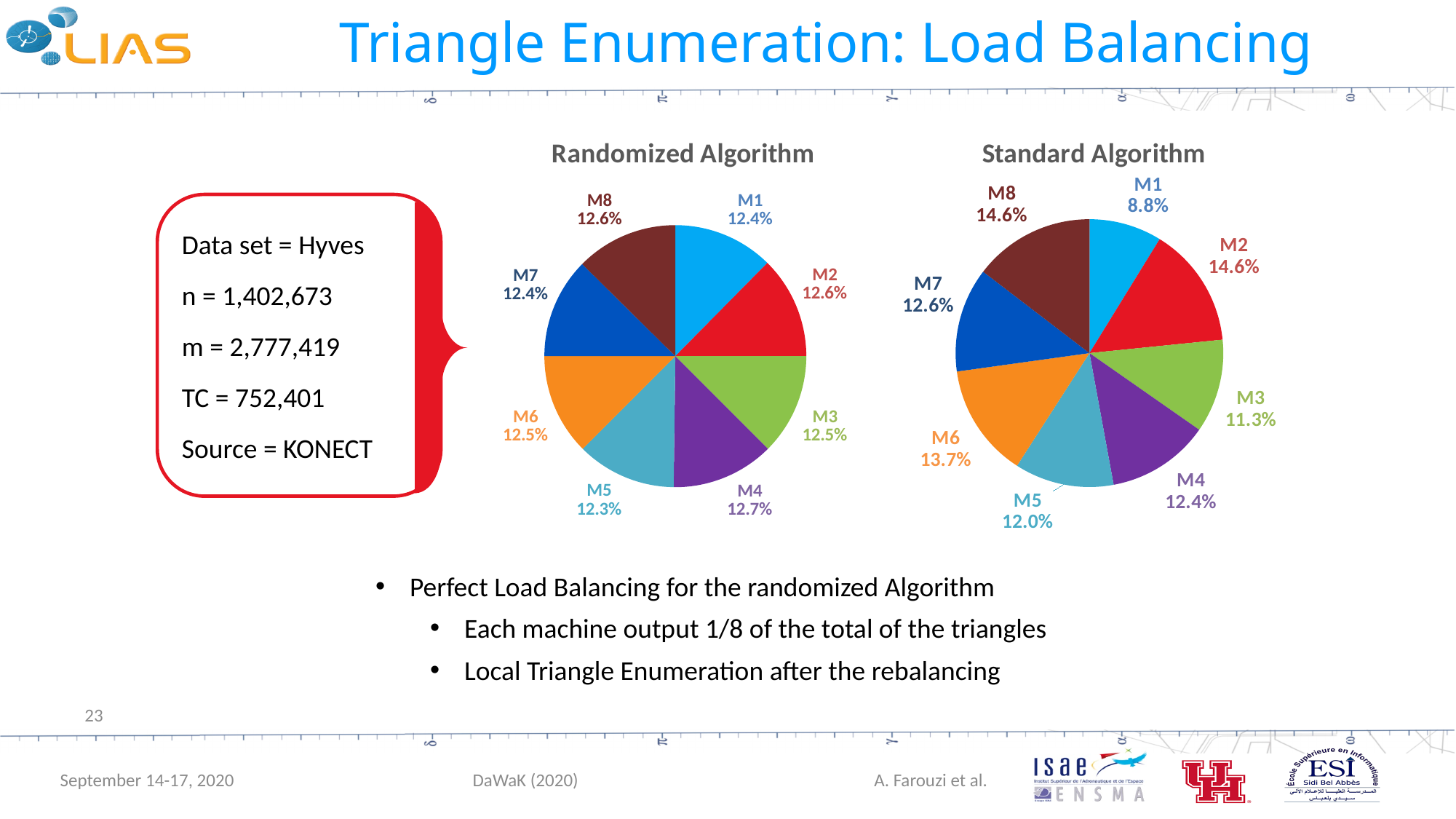
In the Standard Algorithm chart, which machine has the smallest share? M1 In the Standard Algorithm chart, what is the difference between the shares of M7 and M5? 0.6% How many slices does the Randomized Algorithm chart have? 8 In the Standard Algorithm chart, which has the larger share, M8 or M5? M8 In the Standard Algorithm chart, what share does M6 have? 13.7% In the Randomized Algorithm chart, what share does M4 have? 12.7% What is the title of the chart on the left? Randomized Algorithm In the Randomized Algorithm chart, what share does M5 have? 12.3% In the Standard Algorithm chart, what share does M1 have? 8.8% In the Standard Algorithm chart, which has the larger share, M6 or M3? M6 What kind of chart is the Standard Algorithm chart? Pie chart In the Standard Algorithm chart, what is the difference between the shares of M2 and M1? 5.8%